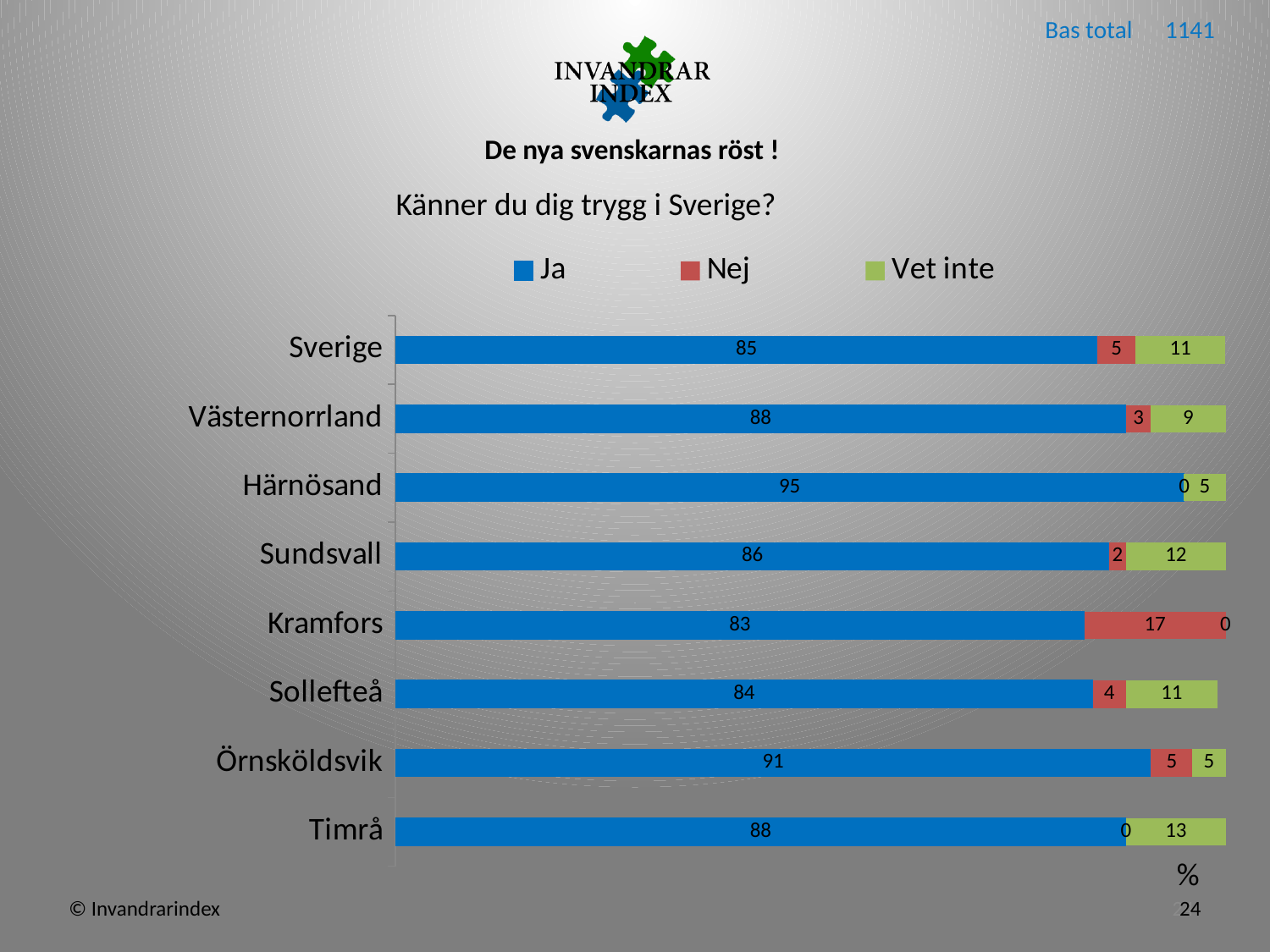
What is the value for Nej for Kramfors? 17 What is the value for Vet inte for Timrå? 13 How many categories are shown on the chart? 8 Which category has the lowest value for Ja? Kramfors How many series does the legend list? 3 What kind of chart is shown on the slide? Stacked bar chart Which category has the highest value for Ja? Härnösand What is the difference between the Ja value for Härnösand and the Ja value for Kramfors? 12 What is the value for Ja for Härnösand? 95 Which category has the highest value for Nej? Kramfors What is the total of the stacked bar for Sundsvall? 100 Which has a larger Ja value, Örnsköldsvik or Västernorrland? Örnsköldsvik